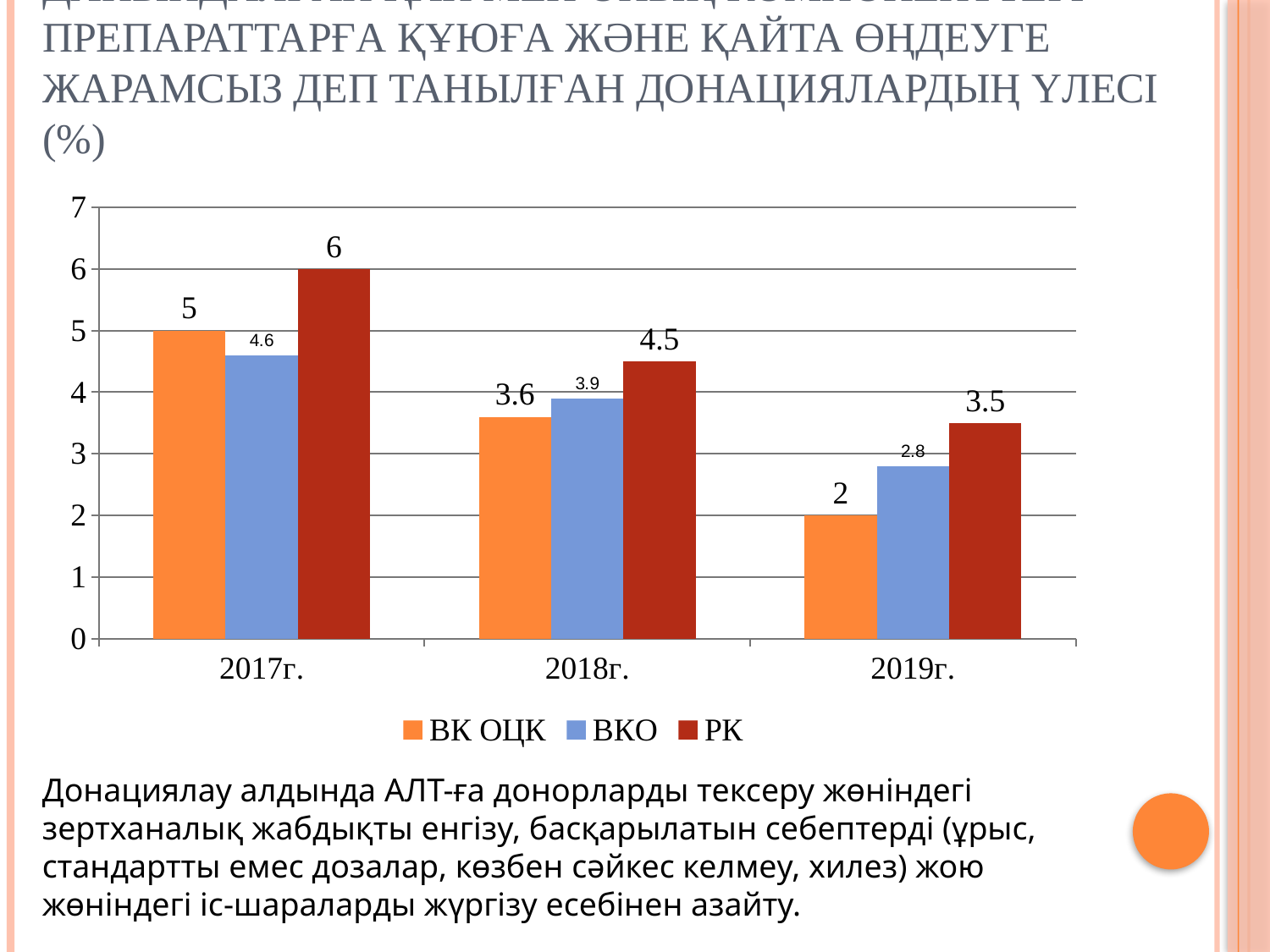
How many years are shown on the x axis? 3 What is the value for ВКО in 2018г.? 3.9 How many series does the legend list? 3 In which year is the value for РК lowest? 2019г. Which is larger in 2018г., the value for ВК ОЦК or the value for ВКО? ВКО What is the value for ВКО in 2019г.? 2.8 What is the difference between the РК value and the ВК ОЦК value in 2017г.? 1 Do the values for РК rise or fall from 2017г. to 2019г.? fall In which year is the value for ВК ОЦК highest? 2017г. What kind of chart is shown on the slide? bar chart What is the value for ВК ОЦК in 2019г.? 2 What is the value for РК in 2017г.? 6